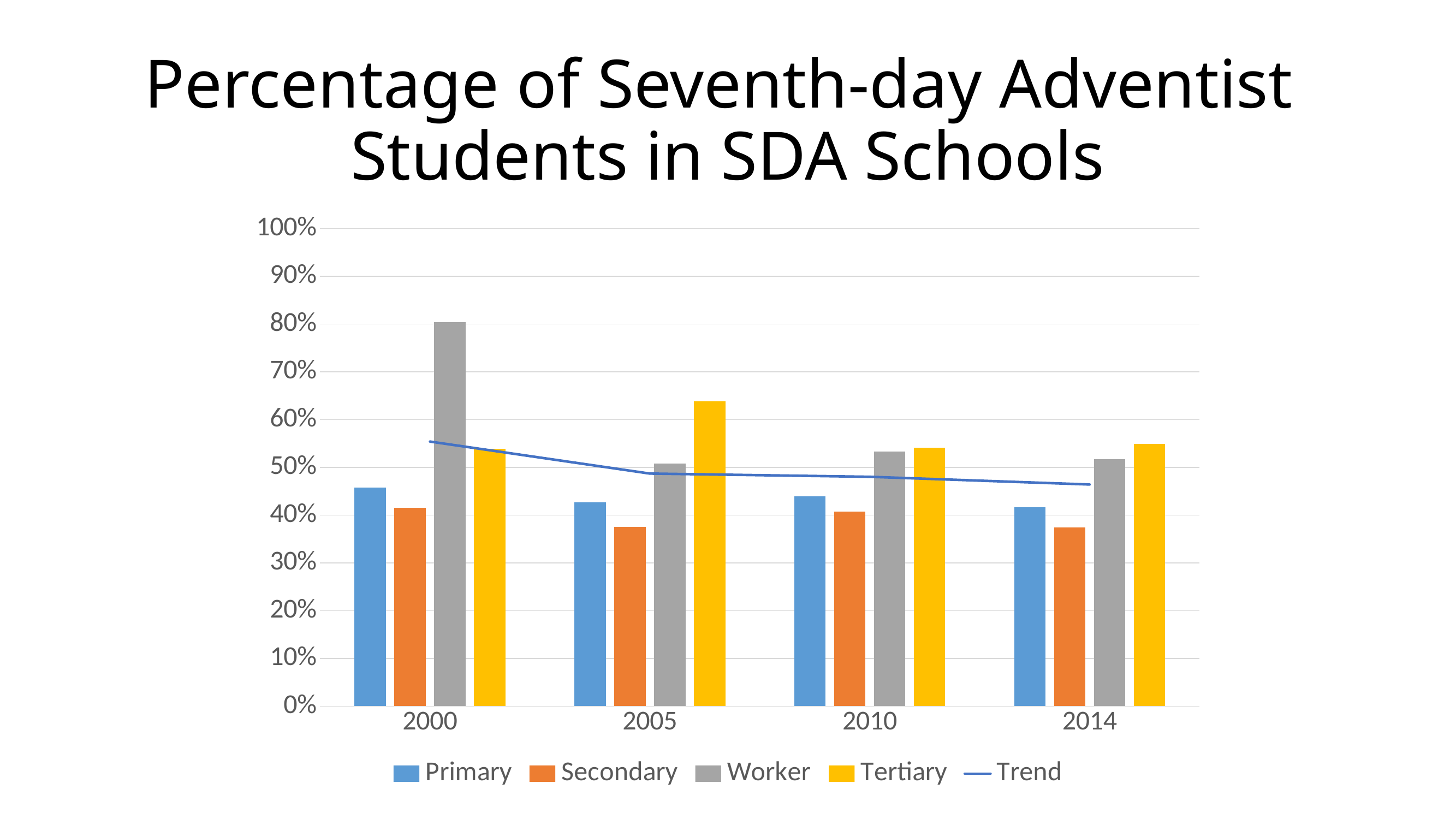
Is the value for Tertiary in 2005 greater or less than 60%? greater Is the value for Primary in 2000 greater or less than 50%? less Which series has the lowest bar in 2005? Secondary Does the Trend line rise or fall from 2000 to 2014? fall Is the value for Worker in 2000 greater or less than 70%? greater In 2005, which is larger, the Tertiary bar or the Worker bar? Tertiary Which series has the highest bar in 2000? Worker What colour are the Tertiary bars? yellow How many years are shown along the x axis? 4 What kind of chart is shown on the slide? combination bar and line chart How many series does the legend list? 5